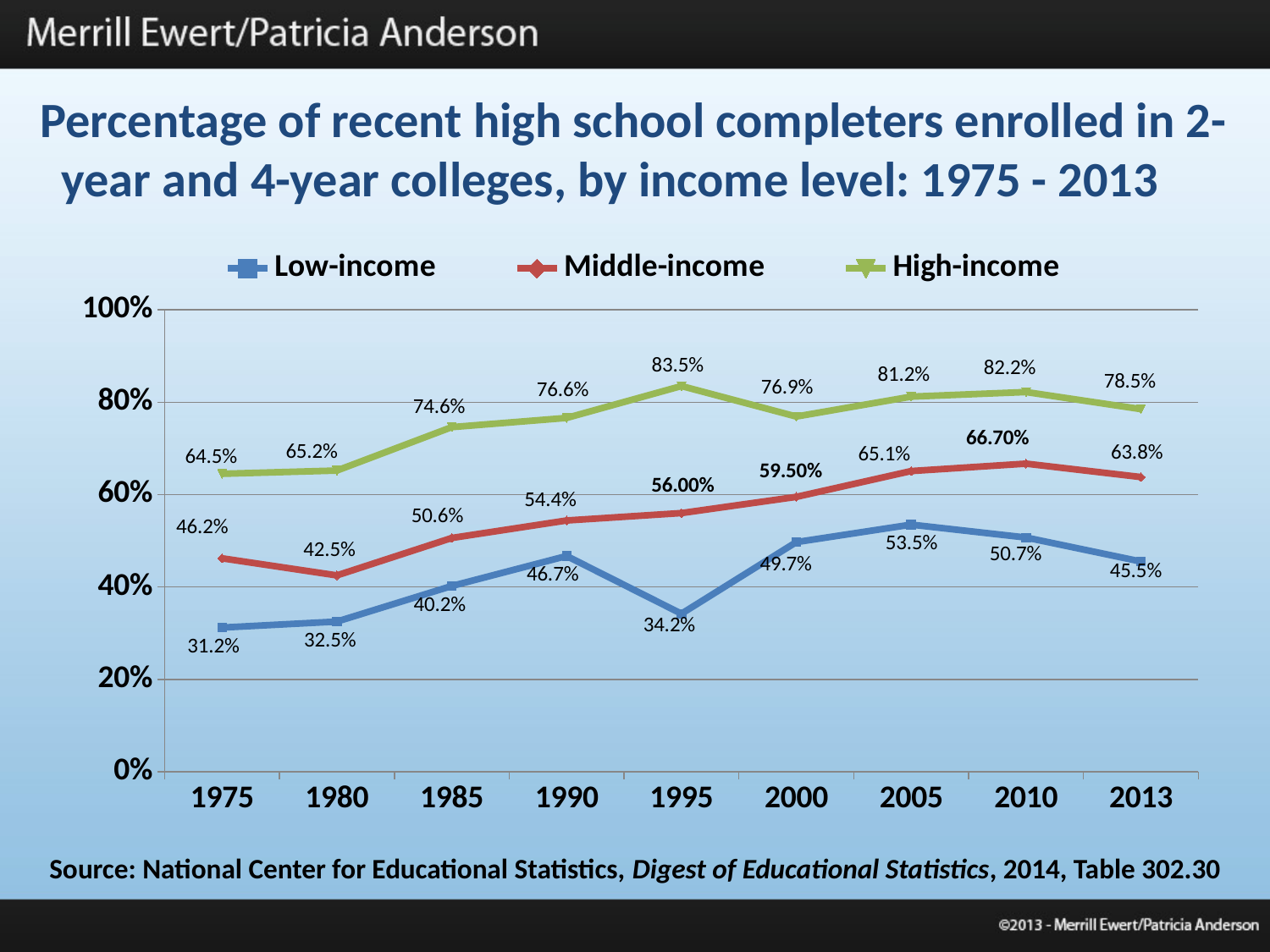
In which year is the High-income series at its highest? 1995 What is the difference between the High-income and Low-income values in 2013? 33.0% What is the value for High-income in 1995? 83.5% What kind of chart is shown on the slide? line chart Is the Middle-income value in 1985 greater or less than 60%? less What is the value for Middle-income in 2010? 66.70% How many series does the legend list? 3 Which is larger: the Low-income value in 2005 or the Low-income value in 1995? 2005 Does the Middle-income series rise or fall from 1980 to 2010? rise How many years are shown on the x axis? 9 In which year is the Low-income series at its lowest? 1975 What is the value for Low-income in 1975? 31.2%